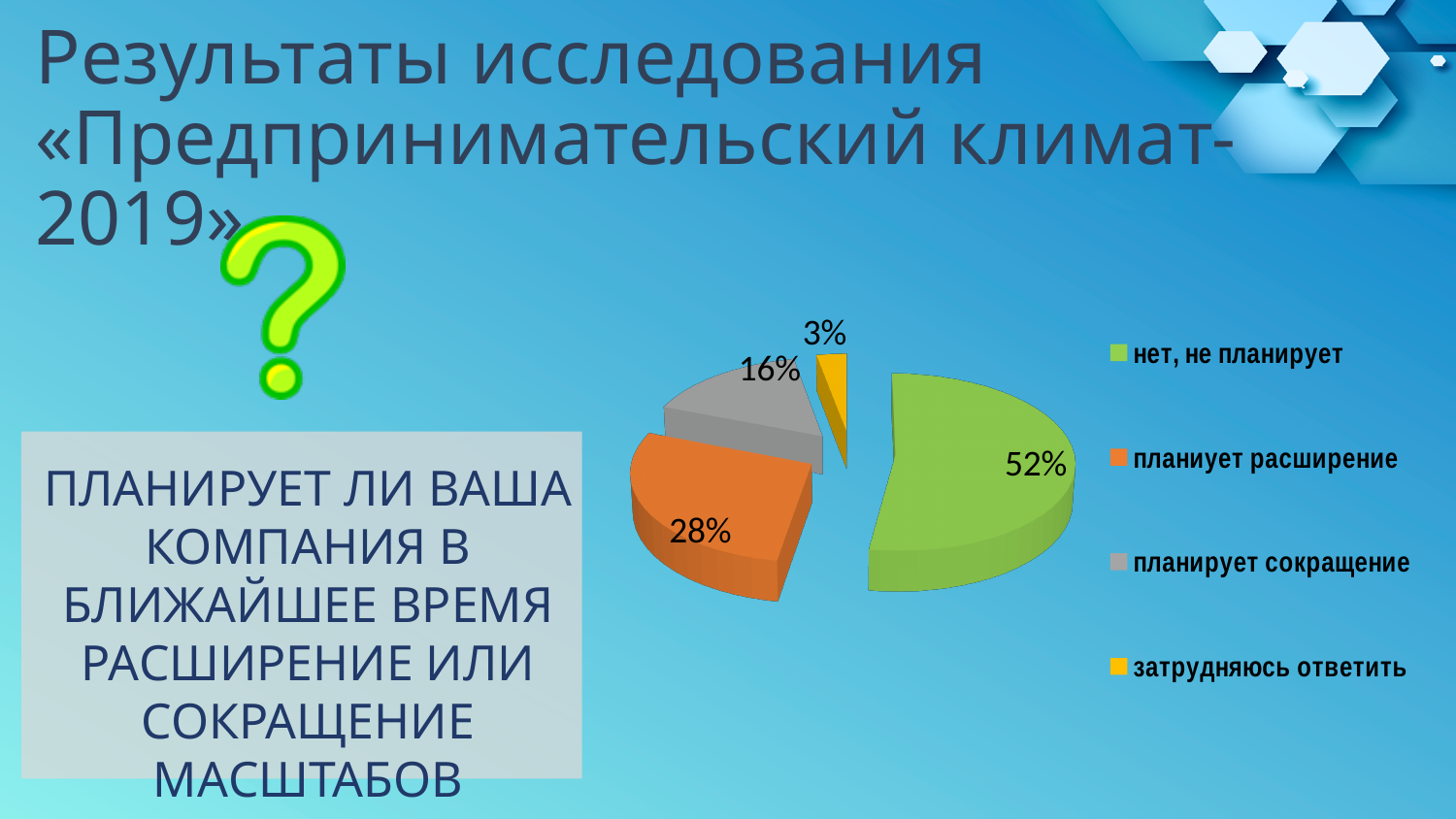
How many slices does the pie chart have? 4 What share of the pie is labelled "планиует расширение"? 28% What share of the pie is labelled "нет, не планирует"? 52% How many entries does the legend list? 4 What colour is the slice for "планиует расширение"? orange What is the difference between the shares for "нет, не планирует" and "планиует расширение"? 24% What share of the pie is labelled "планирует сокращение"? 16% Which category has the smallest slice of the pie? затрудняюсь ответить What kind of chart is shown on the slide? pie chart Which is larger: the share for "планирует сокращение" or the share for "затрудняюсь ответить"? планирует сокращение What share of the pie is labelled "затрудняюсь ответить"? 3% Which category has the largest slice of the pie? нет, не планирует